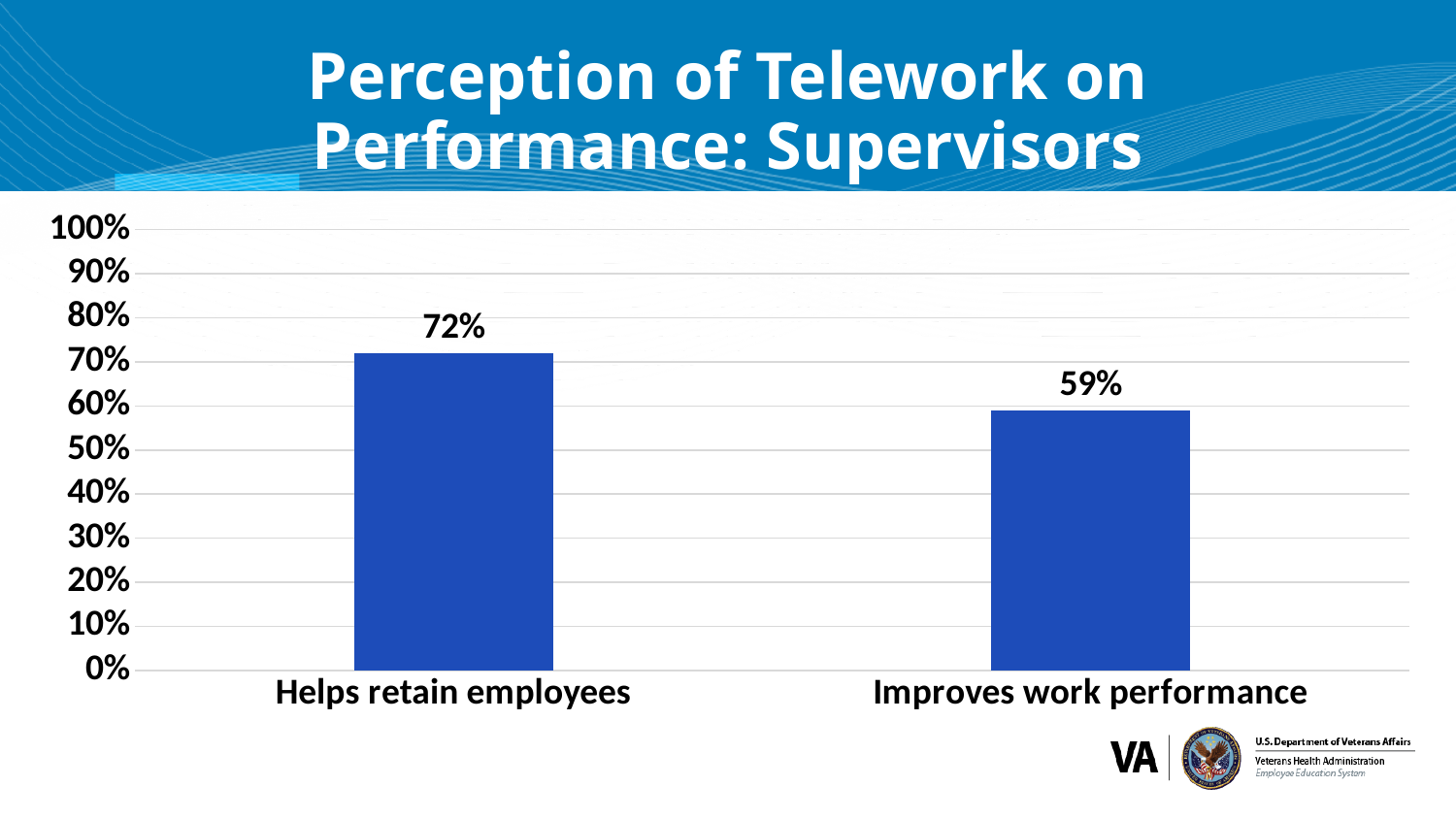
Which is larger: the value for "Helps retain employees" or the value for "Improves work performance"? Helps retain employees What is the title of the slide? Perception of Telework on Performance: Supervisors What is the maximum value shown on the vertical axis? 100% What is the value for "Helps retain employees"? 72% Which category has the highest value? Helps retain employees How many categories are shown in the chart? 2 Is the value for "Helps retain employees" greater or less than 70%? greater Is the value for "Improves work performance" greater or less than 60%? less Which category has the lowest value? Improves work performance What kind of chart is shown on the slide? Bar chart What is the value for "Improves work performance"? 59% What is the difference between the values for "Helps retain employees" and "Improves work performance"? 13%